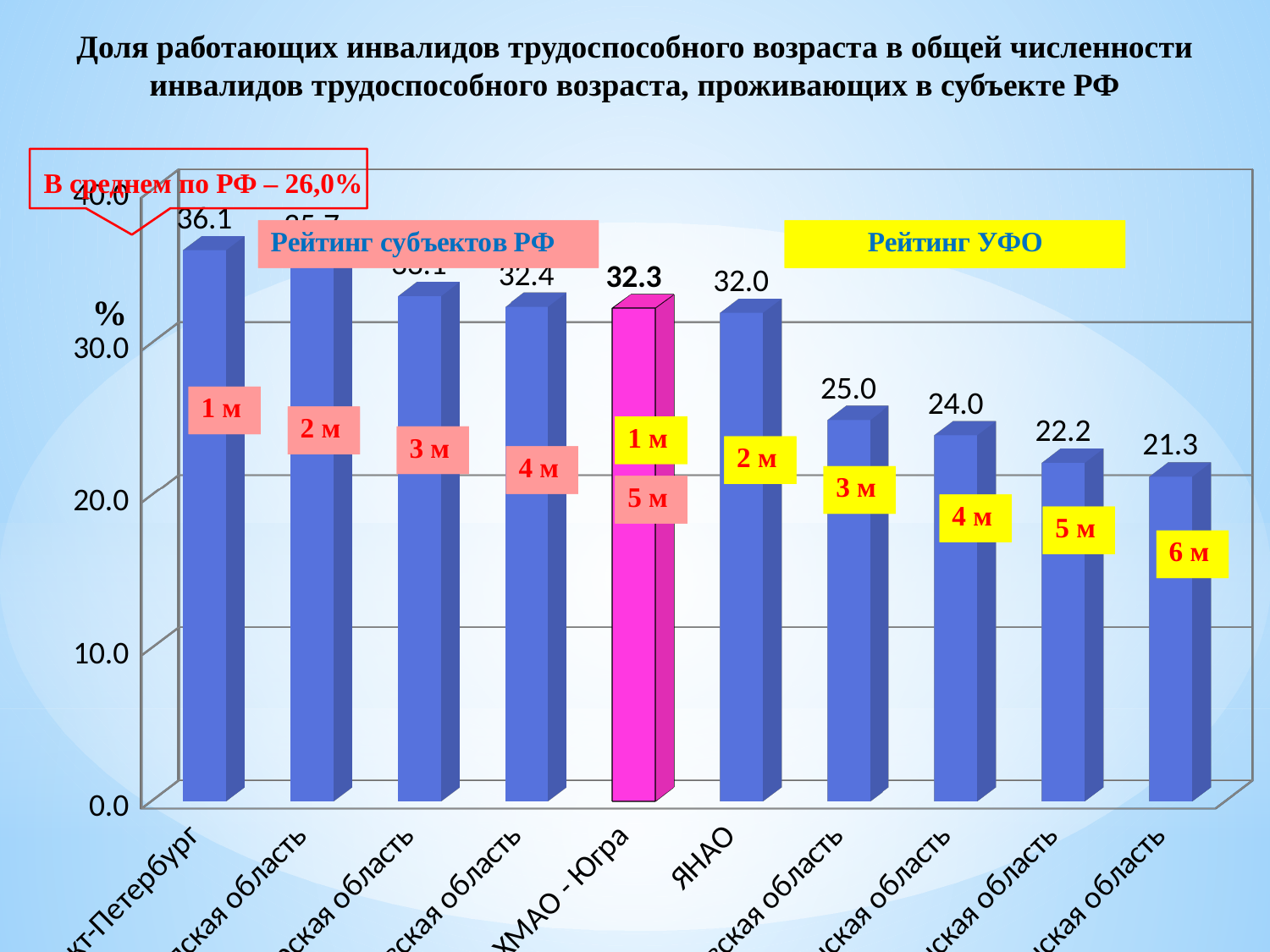
What kind of chart is shown on the slide? bar chart Do the bar values rise or fall from left to right along the x axis? fall Which has the larger value, ХМАО - Югра or ЯНАО? ХМАО - Югра What is the value shown for ЯНАО? 32.0 What average value for the RF (В среднем по РФ) is shown on the slide? 26,0% How many bars are plotted in the chart? 10 What is the value of the rightmost bar in the chart? 21.3 What is the value shown for ХМАО - Югра? 32.3 Is the value for ЯНАО greater or less than 30.0? greater What is the difference between the values for ХМАО - Югра and ЯНАО? 0.3 What colour is the bar for ХМАО - Югра? pink What is the value of the highest bar in the chart? 36.1